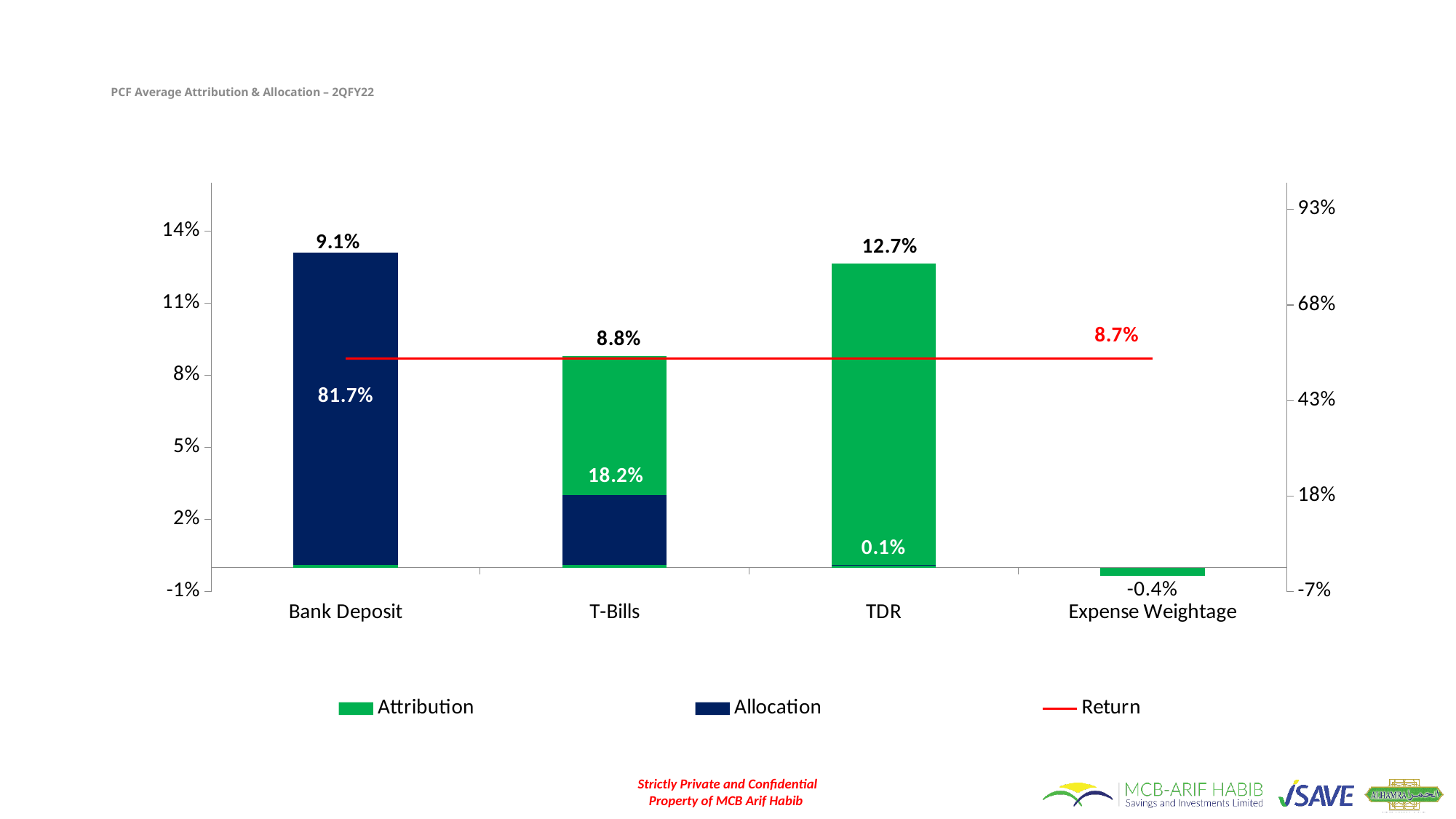
Which category has the lowest Allocation value among those labelled? TDR What is the Allocation value for Bank Deposit? 81.7% Which is larger, the Attribution value for T-Bills or for Bank Deposit? Bank Deposit What is the difference between the Attribution values for TDR and Bank Deposit? 3.6% How many categories are shown on the x axis? 4 What is the Allocation value for T-Bills? 18.2% Which category has the highest Attribution value? TDR How many series does the legend list? 3 What value is shown for the Return line? 8.7% What is the Attribution value for TDR? 12.7% What is the title of the chart? PCF Average Attribution & Allocation – 2QFY22 What is the Attribution value for Expense Weightage? -0.4%